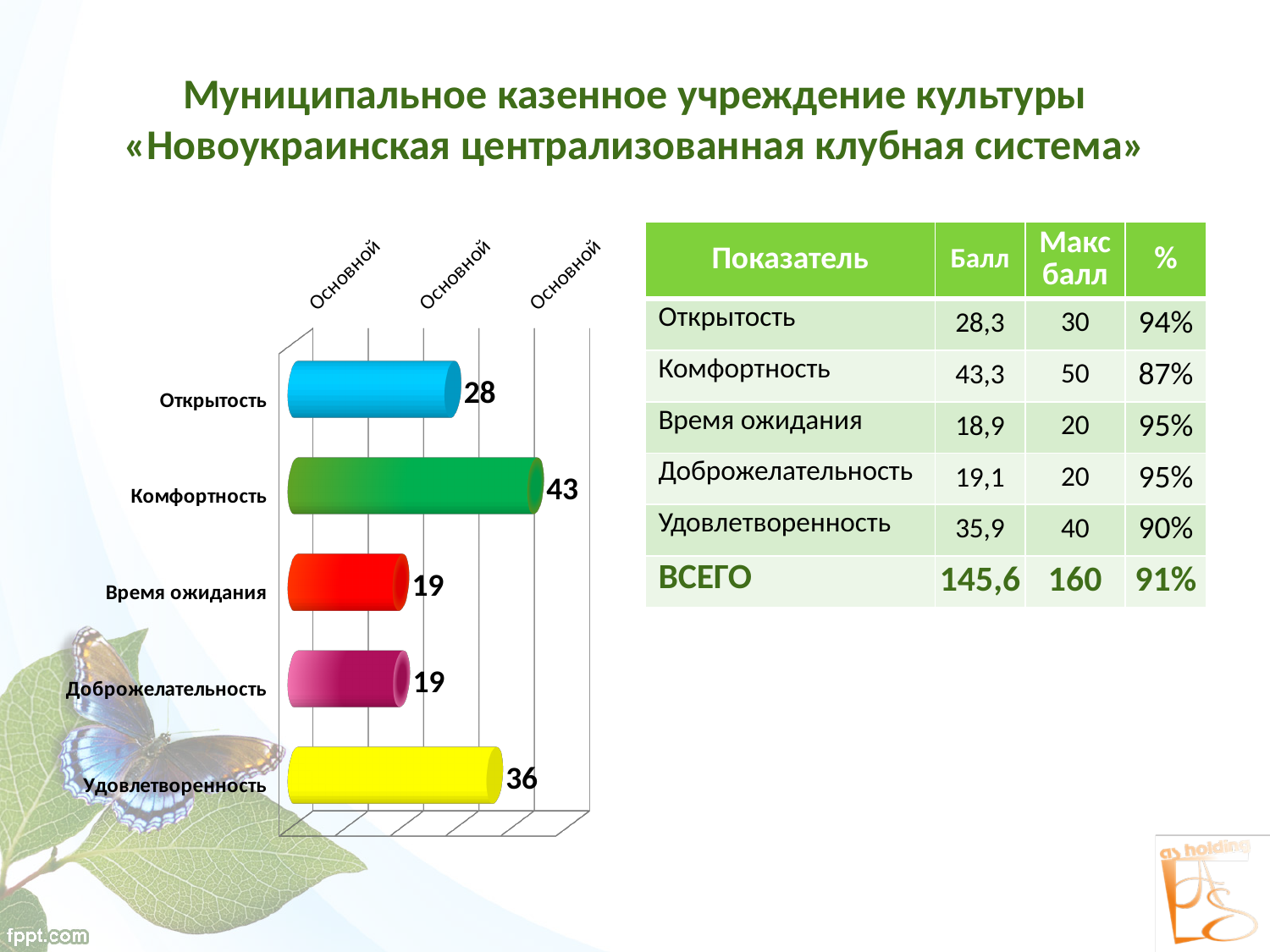
Which is larger on the chart, the value for Комфортность or the value for Удовлетворенность? Комфортность What kind of chart is shown on the slide? Bar chart What value is shown for Удовлетворенность on the chart? 36 What value is shown for Комфортность on the chart? 43 What is the difference between the values for Удовлетворенность and Доброжелательность? 17 What value is shown for Время ожидания on the chart? 19 What is the difference between the values for Комфортность and Открытость? 15 What value is shown for Открытость on the chart? 28 What colour is the bar for Удовлетворенность? Yellow Which category has the highest value on the chart? Комфортность Which is larger on the chart, the value for Открытость or the value for Удовлетворенность? Удовлетворенность How many categories are plotted on the chart? 5